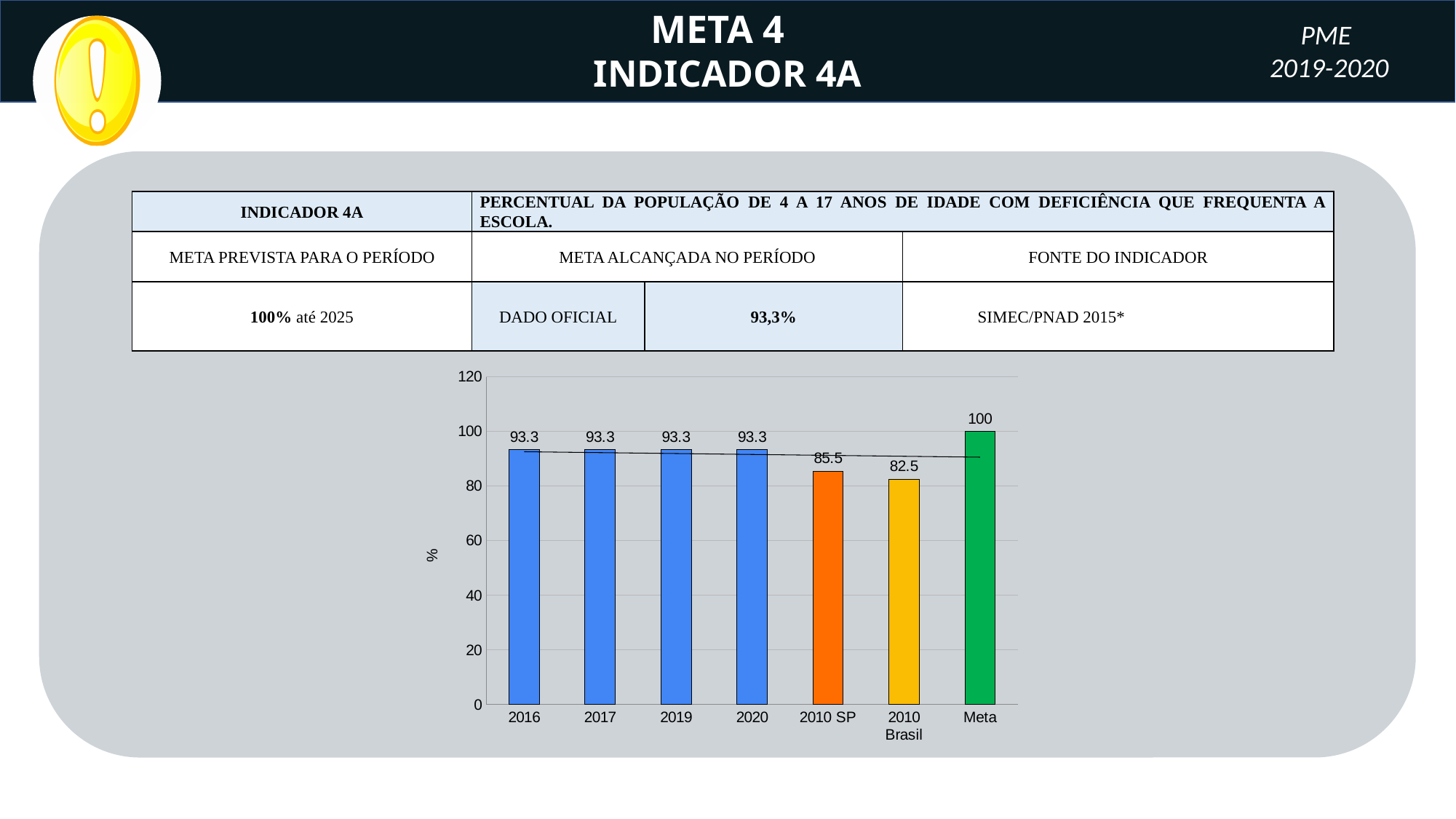
What is the value for Meta in the bar chart? 100 Which category has the highest value in the bar chart? Meta Which category has the lowest value in the bar chart? 2010 Brasil What is the difference between the Meta value and the 2020 value? 6.7 Which is larger, the value for 2010 SP or the value for 2010 Brasil? 2010 SP How many bars are shown in the chart? 7 What is the value for 2010 SP in the bar chart? 85.5 What is the difference between the 2010 SP value and the 2010 Brasil value? 3 Is the value for 2010 Brasil greater or less than 100? less What type of chart is shown on the slide? bar chart What is the value for 2010 Brasil in the bar chart? 82.5 What is the value for 2016 in the bar chart? 93.3